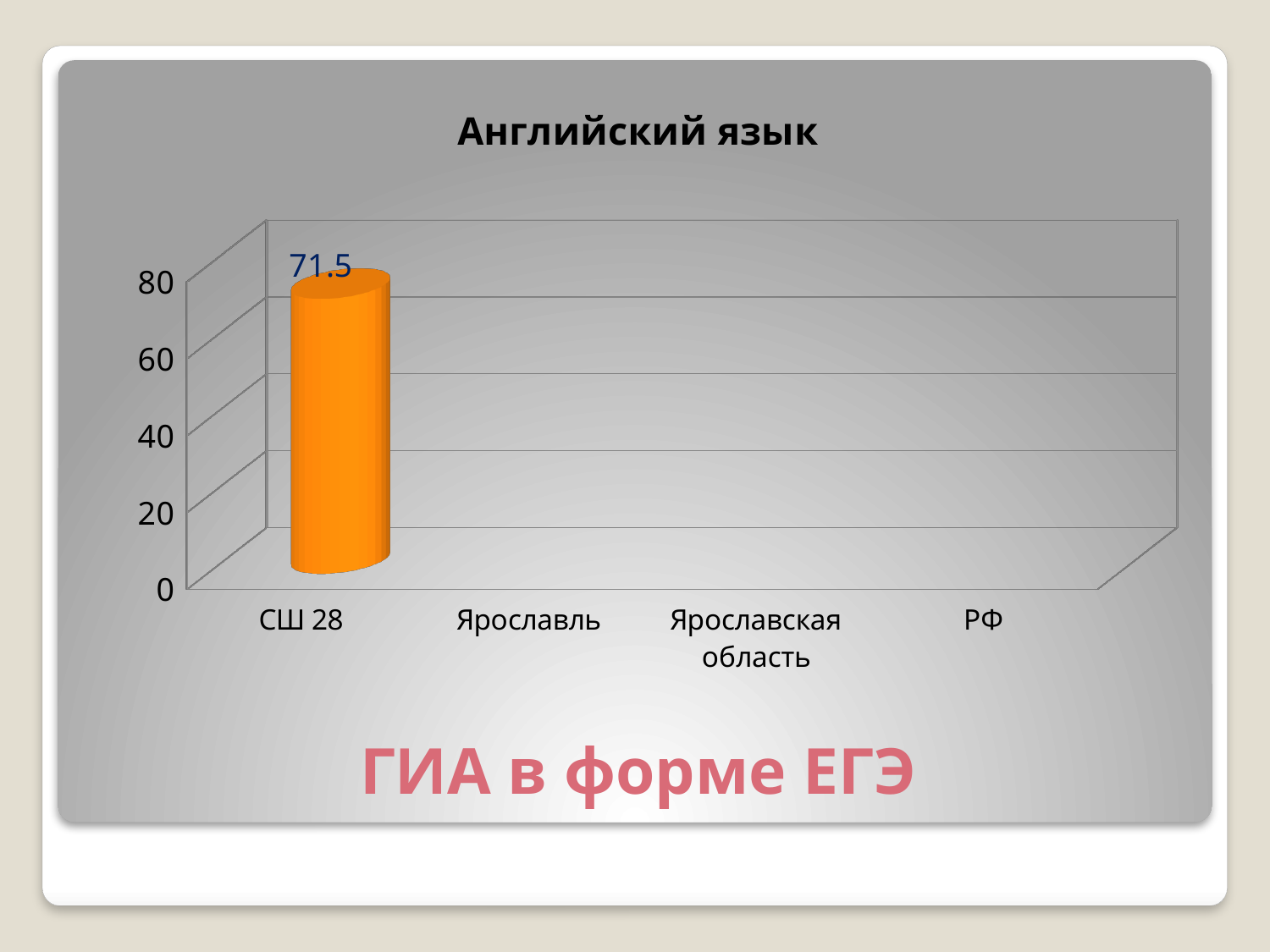
Which category has the highest value in the chart? СШ 28 What kind of chart is shown on the slide? bar chart How many categories are listed on the x axis of the chart? 4 What colour is the bar for СШ 28? orange What is the highest tick value shown on the vertical axis? 80 What is the title of the chart? Английский язык Is the value for СШ 28 greater or less than 80? less Is the value for СШ 28 greater or less than 60? greater What is the value for СШ 28 in the chart? 71.5 Which category is listed last on the x axis? РФ How many categories in the chart have a bar plotted? 1